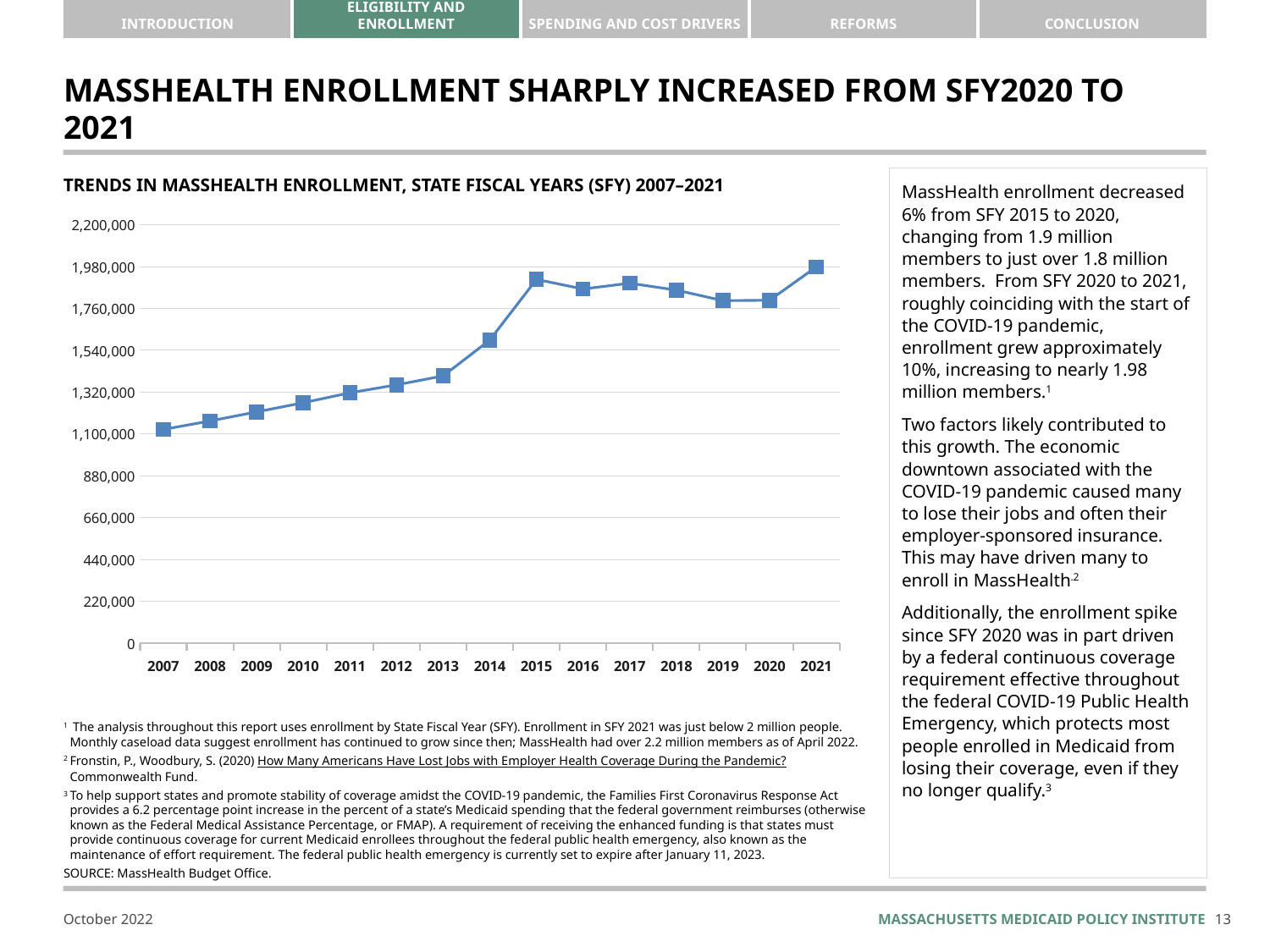
Does MassHealth enrollment rise or fall from 2007 to 2015? rise Is the enrollment value for 2013 greater or less than 1,320,000? greater What is the title of the chart? Trends in MassHealth Enrollment, State Fiscal Years (SFY) 2007–2021 Which year has higher enrollment, 2014 or 2015? 2015 Which state fiscal year has the lowest MassHealth enrollment in the chart? 2007 Which state fiscal year has the highest MassHealth enrollment in the chart? 2021 How many state fiscal years are plotted on the x axis of the chart? 15 What kind of chart is shown on the slide? line chart Is the enrollment value for 2007 greater or less than 1,320,000? less Which year has higher enrollment, 2020 or 2021? 2021 Is the enrollment value for 2015 greater or less than 1,760,000? greater